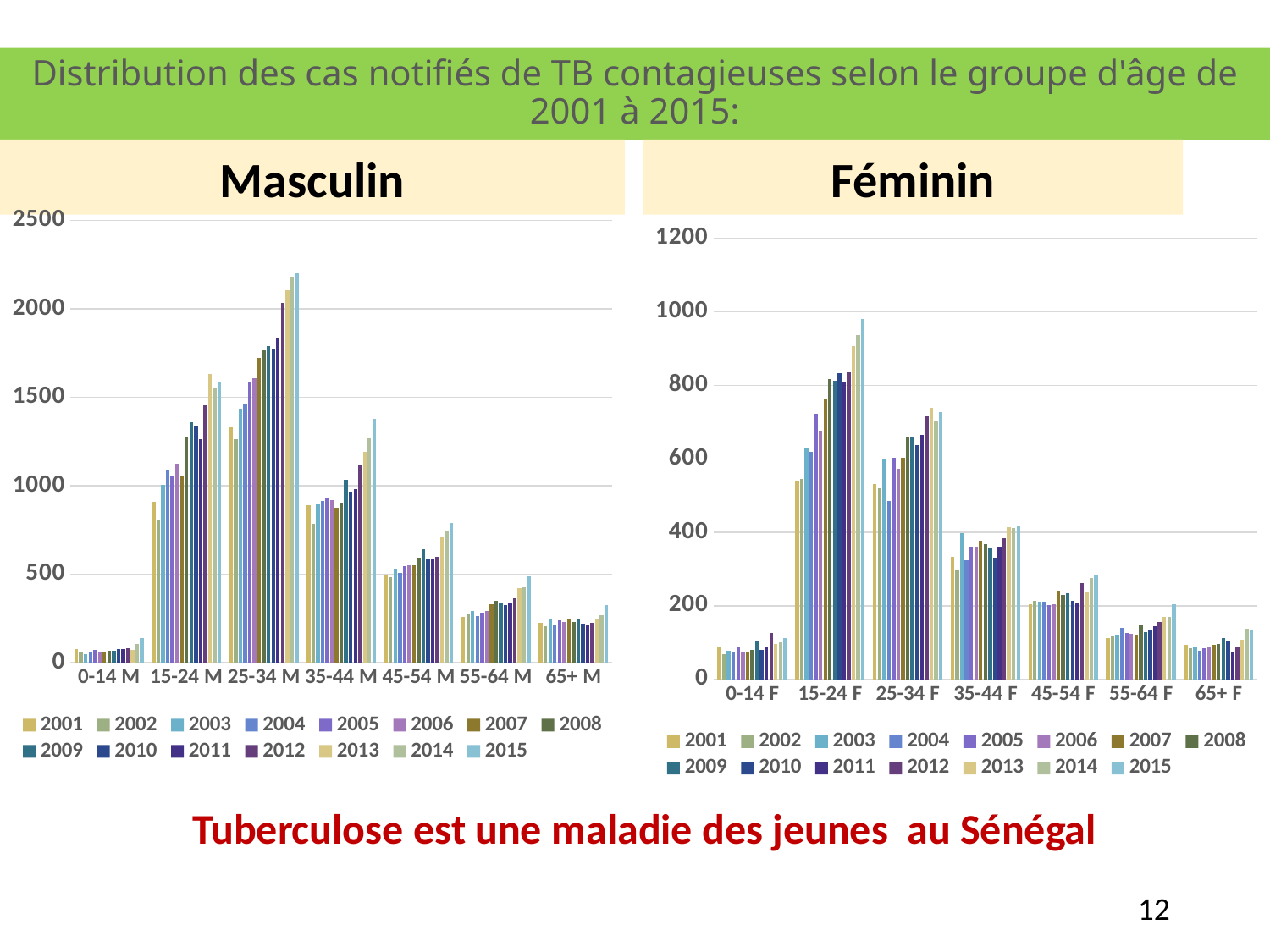
How many age-group categories are shown on the Féminin chart? 7 On the Masculin chart, which is larger for 2015: 15-24 M or 25-34 M? 25-34 M On the Masculin chart, do the values rise or fall along the x axis from 25-34 M to 65+ M? fall How many series does the legend of the Masculin chart list? 15 On the Masculin chart, which age group has the lowest bars overall? 0-14 M What kind of chart is the Masculin chart? bar chart On the Féminin chart, which age group has the highest bars overall? 15-24 F On the Masculin chart, which age group has the highest bars overall? 25-34 M On the Masculin chart, is the value for 25-34 M in 2015 greater or less than 2000? greater On the Féminin chart, is the value for 15-24 F in 2015 greater or less than 800? greater On the Féminin chart, which is larger for 2015: 15-24 F or 25-34 F? 15-24 F On the Féminin chart, is the value for 65+ F in 2015 greater or less than 200? less